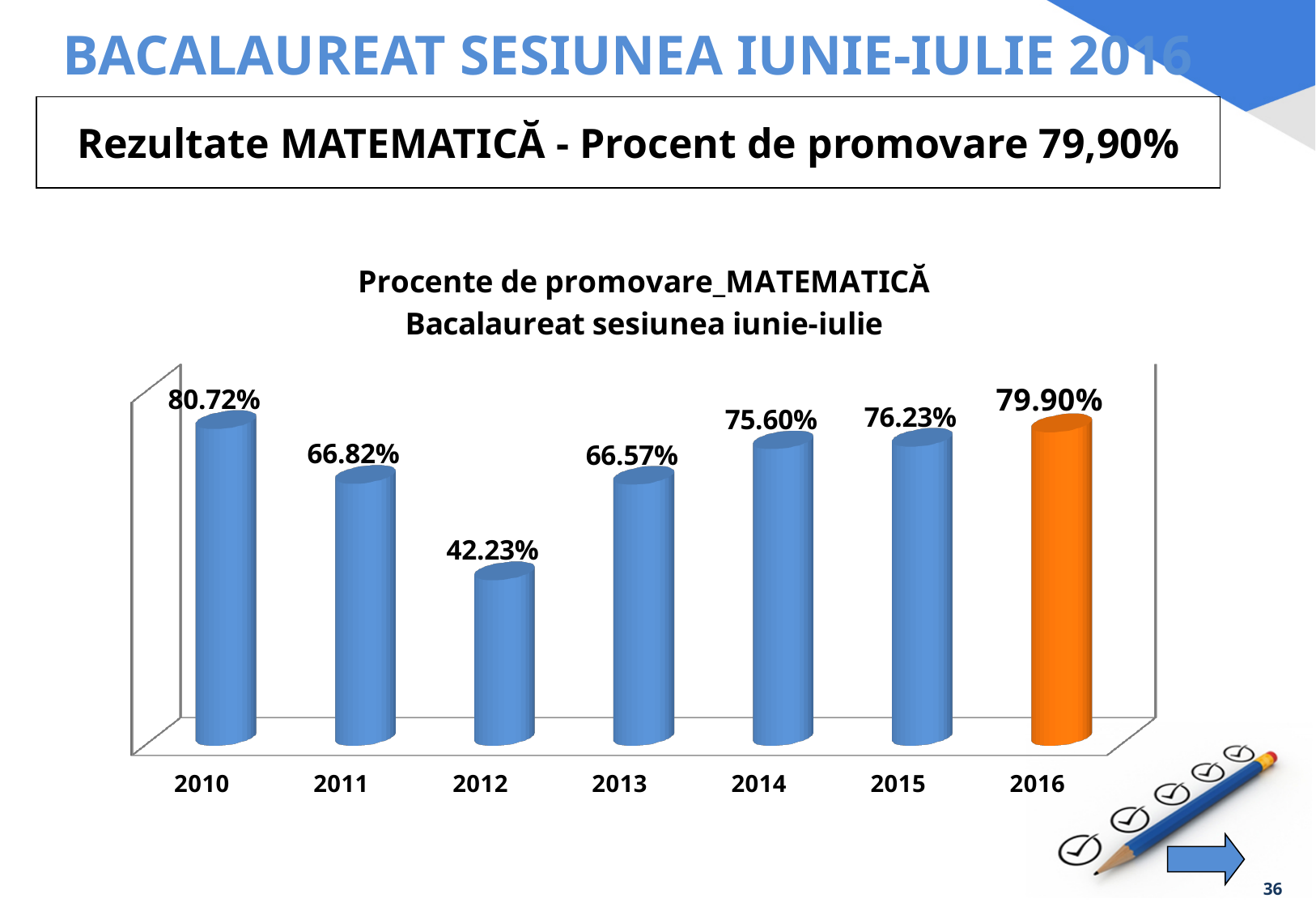
What is the pass rate for 2012? 42.23% Which year has the lowest pass rate? 2012 How many years are shown on the chart? 7 What is the pass rate for 2010? 80.72% Which year has a higher pass rate, 2011 or 2013? 2011 What is the pass rate for 2016? 79.90% What is the pass rate for 2014? 75.60% What is the difference in pass rate between 2016 and 2015? 3.67% What is the difference in pass rate between 2010 and 2012? 38.49% What kind of chart is shown on the slide? Bar chart Which bar is coloured orange instead of blue? 2016 Which year has the highest pass rate? 2010